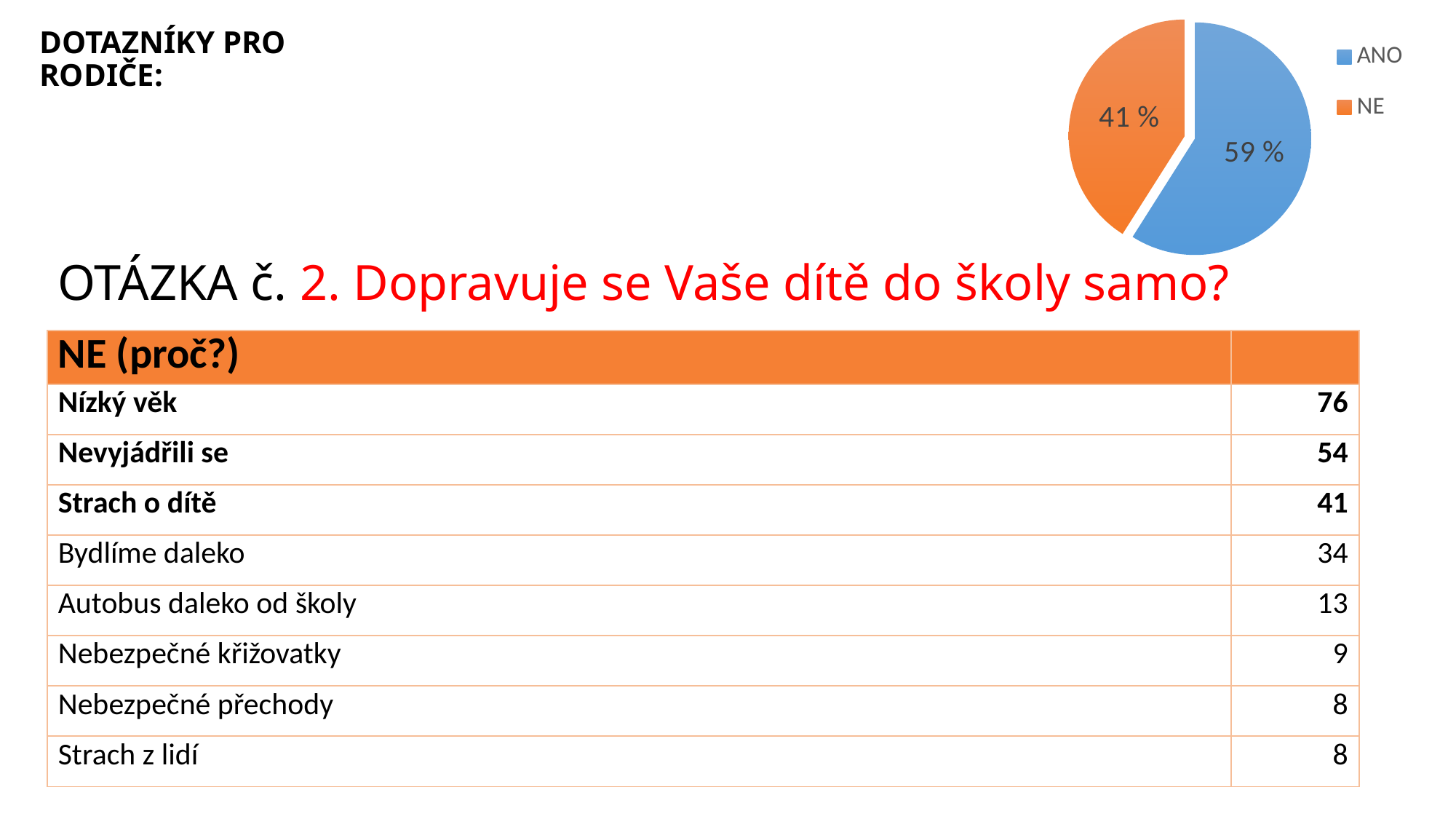
Is the ANO slice of the pie chart greater or less than 50 %? greater What share of the pie chart is labelled NE? 41 % Which slice of the pie chart is the largest? ANO What share of the pie chart is labelled ANO? 59 % Which slice of the pie chart is the smallest? NE How many slices does the pie chart have? 2 What colour is the NE slice in the pie chart? orange What kind of chart is shown at the top right of the slide? pie chart What colour is the ANO slice in the pie chart? blue What is the difference in percentage points between the ANO and NE slices of the pie chart? 18 How many entries does the pie chart legend list? 2 In the pie chart, which is larger, ANO or NE? ANO